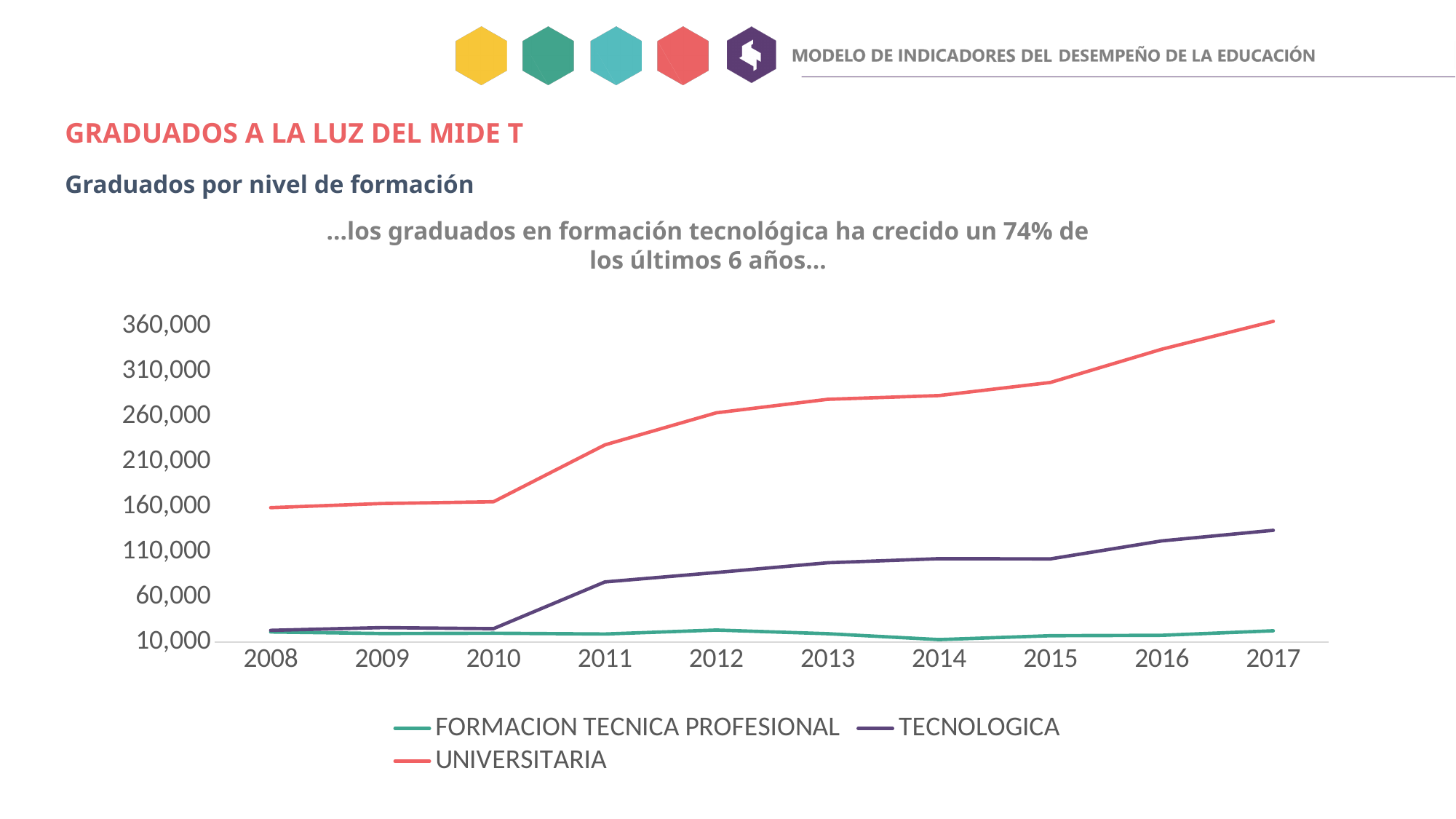
Is the value for TECNOLOGICA in 2008 greater or less than 60,000? less How many series does the legend list? 3 What is the title of the chart? Graduados por nivel de formación How many years are shown along the x axis? 10 Which series has the highest value in 2017? UNIVERSITARIA Is the value for UNIVERSITARIA in 2017 greater or less than 310,000? greater What kind of chart is shown on the slide? Line chart Does the UNIVERSITARIA series rise or fall from 2008 to 2017? Rise Is the value for TECNOLOGICA in 2017 greater or less than 110,000? greater Which is larger in 2014, TECNOLOGICA or FORMACION TECNICA PROFESIONAL? TECNOLOGICA Which series has the lowest value in 2017? FORMACION TECNICA PROFESIONAL